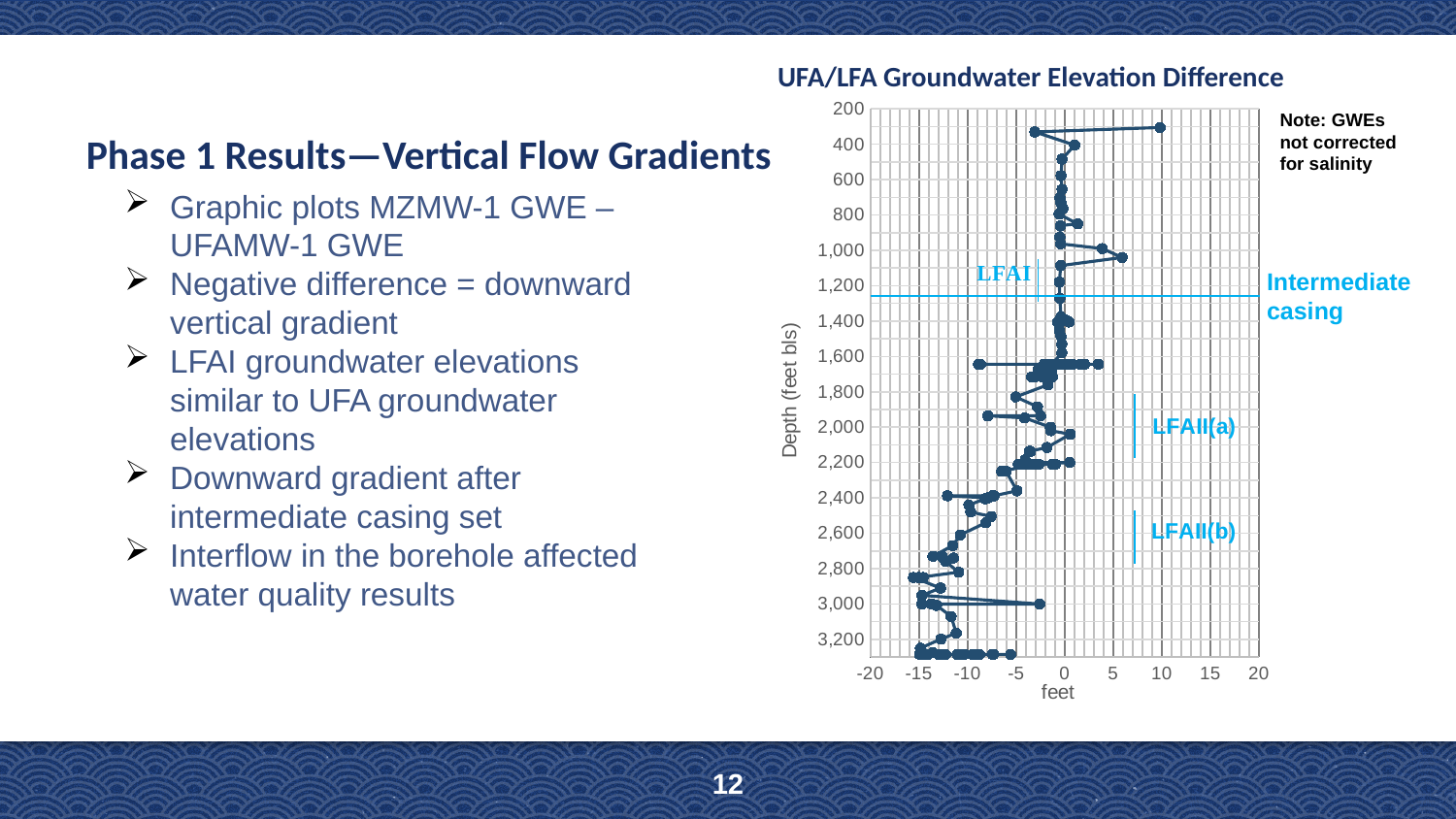
What is the label of the horizontal axis of the chart? feet Is the most negative value plotted on the chart greater or less than -10 feet? less Is the value plotted at about 600 feet depth greater or less than -5 feet? greater Which has the larger elevation difference, the point at about 300 feet depth or the points at about 3,000 feet depth? 300 feet depth As depth increases down the chart, do the plotted elevation differences generally increase or decrease? decrease Is the largest value plotted on the chart (near 300 feet depth) greater or less than 5 feet? greater What kind of chart is shown on the slide? line chart What is the title of the chart? UFA/LFA Groundwater Elevation Difference